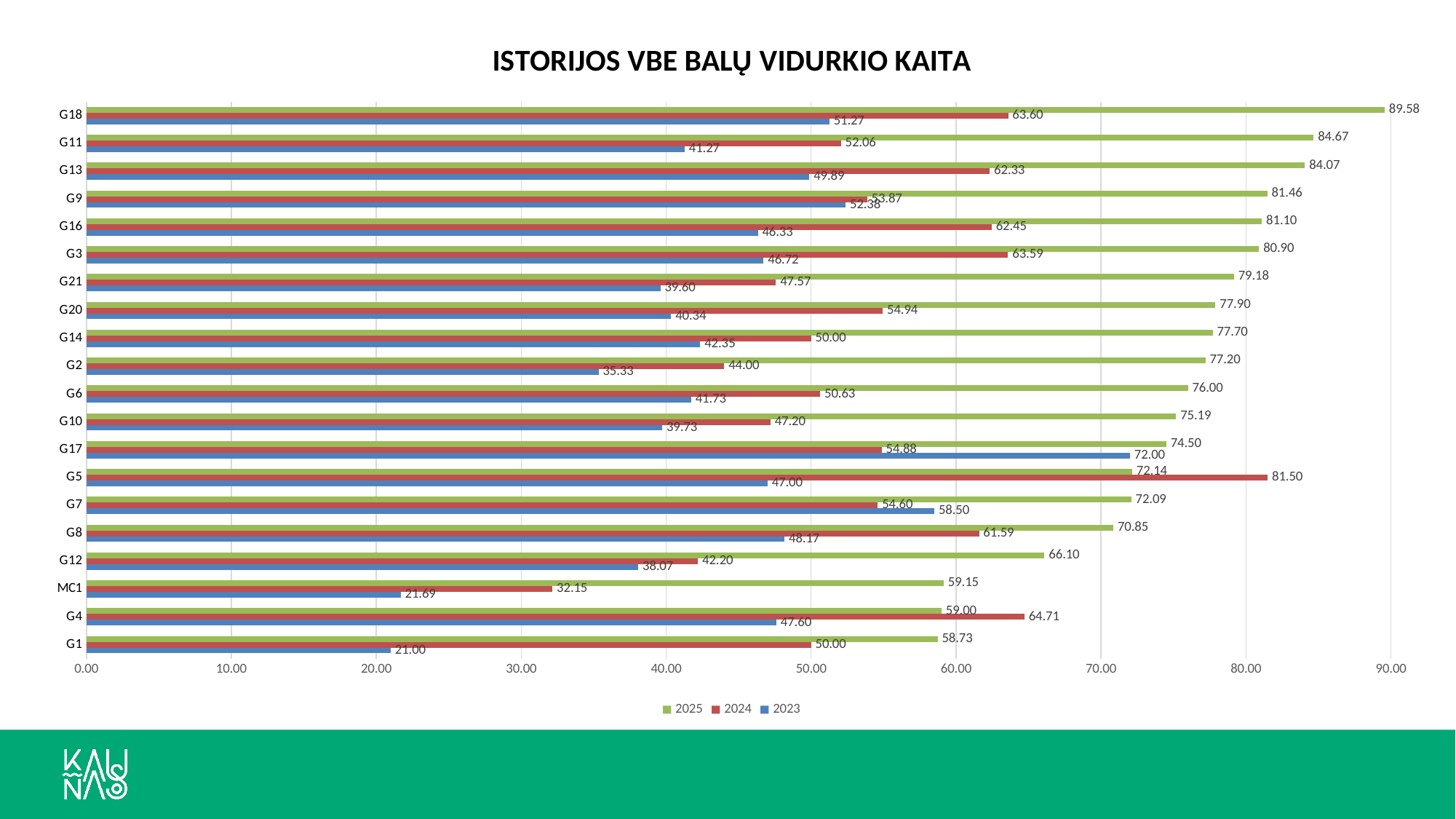
What is the 2023 value for MC1? 21.69 What is the 2025 value for G18? 89.58 For G17, which is larger: the 2023 value or the 2024 value? 2023 How many categories are shown on the chart? 20 What is the title of the chart? ISTORIJOS VBE BALŲ VIDURKIO KAITA Which category has the lowest 2023 value? G1 What is the 2024 value for G5? 81.50 What is the difference between the 2025 and 2024 values for G18? 25.98 For G5, which is larger: the 2024 value or the 2025 value? 2024 Which category has the highest 2025 value? G18 What kind of chart is shown on the slide? Bar chart How many series does the legend list? 3